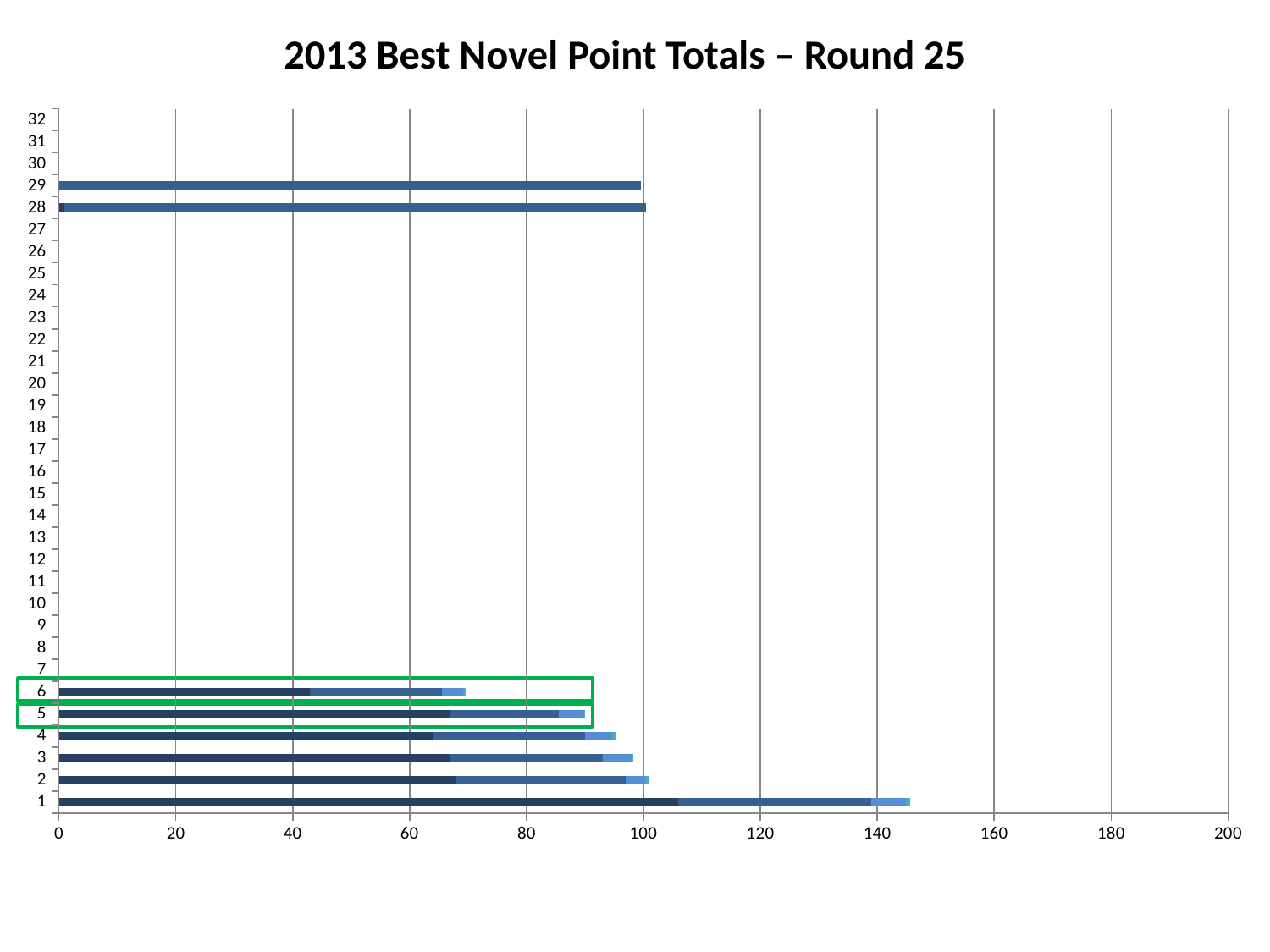
Is the total value for category 6 greater or less than 80? less Which has the larger total value, category 6 or category 29? 29 Which has the larger total value, category 1 or category 2? 1 Among the categories that have bars, which one has the shortest bar? 6 Which two categories are outlined with green rectangles on the chart? 5 and 6 Is the total value for category 1 greater or less than 140? greater Is the total value for category 5 greater or less than 80? greater How many categories are listed on the vertical axis of the chart? 32 What kind of chart is shown on the slide? Bar chart Which category has the longest bar in the chart? 1 What is the title of the chart? 2013 Best Novel Point Totals – Round 25